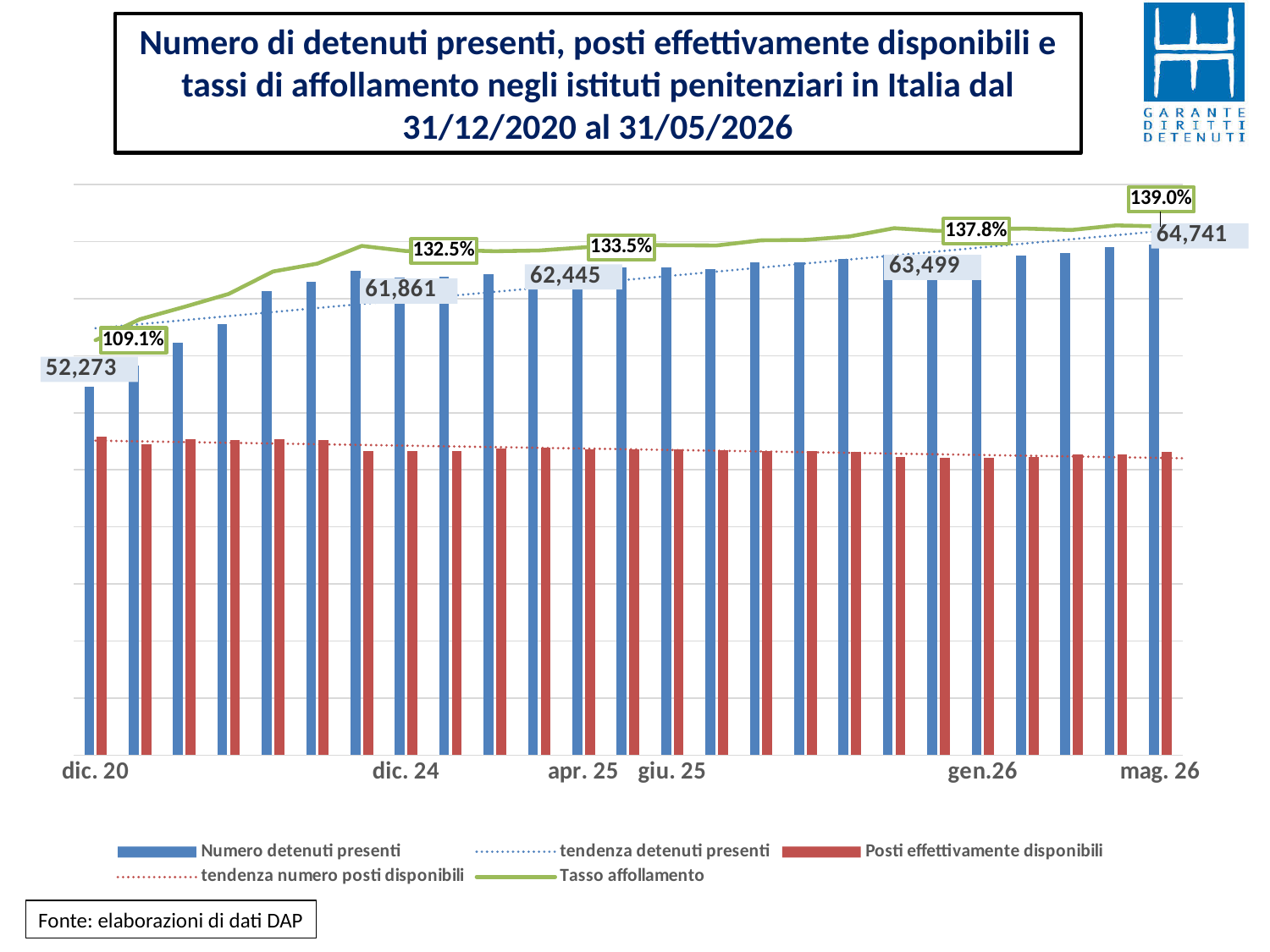
How many series does the legend list? 5 At mag. 26, which is larger: Numero detenuti presenti or Posti effettivamente disponibili? Numero detenuti presenti Which is larger, Numero detenuti presenti at gen.26 or at apr. 25? gen.26 What is the Tasso affollamento at mag. 26? 139.0% What is the Tasso affollamento at dic. 24? 132.5% What is the difference between the Tasso affollamento at mag. 26 (139.0%) and at dic. 20 (109.1%)? 29.9 percentage points What is the value of Numero detenuti presenti at dic. 20? 52,273 Does the dotted trend line for Posti effettivamente disponibili (tendenza numero posti disponibili) rise or fall across the chart? Fall Does the Tasso affollamento line generally rise or fall from dic. 20 to mag. 26? Rise What is the value of Numero detenuti presenti at mag. 26? 64,741 What kind of chart is shown on the slide? Bar and line chart By how much did Numero detenuti presenti increase from dic. 20 (52,273) to mag. 26 (64,741)? 12,468